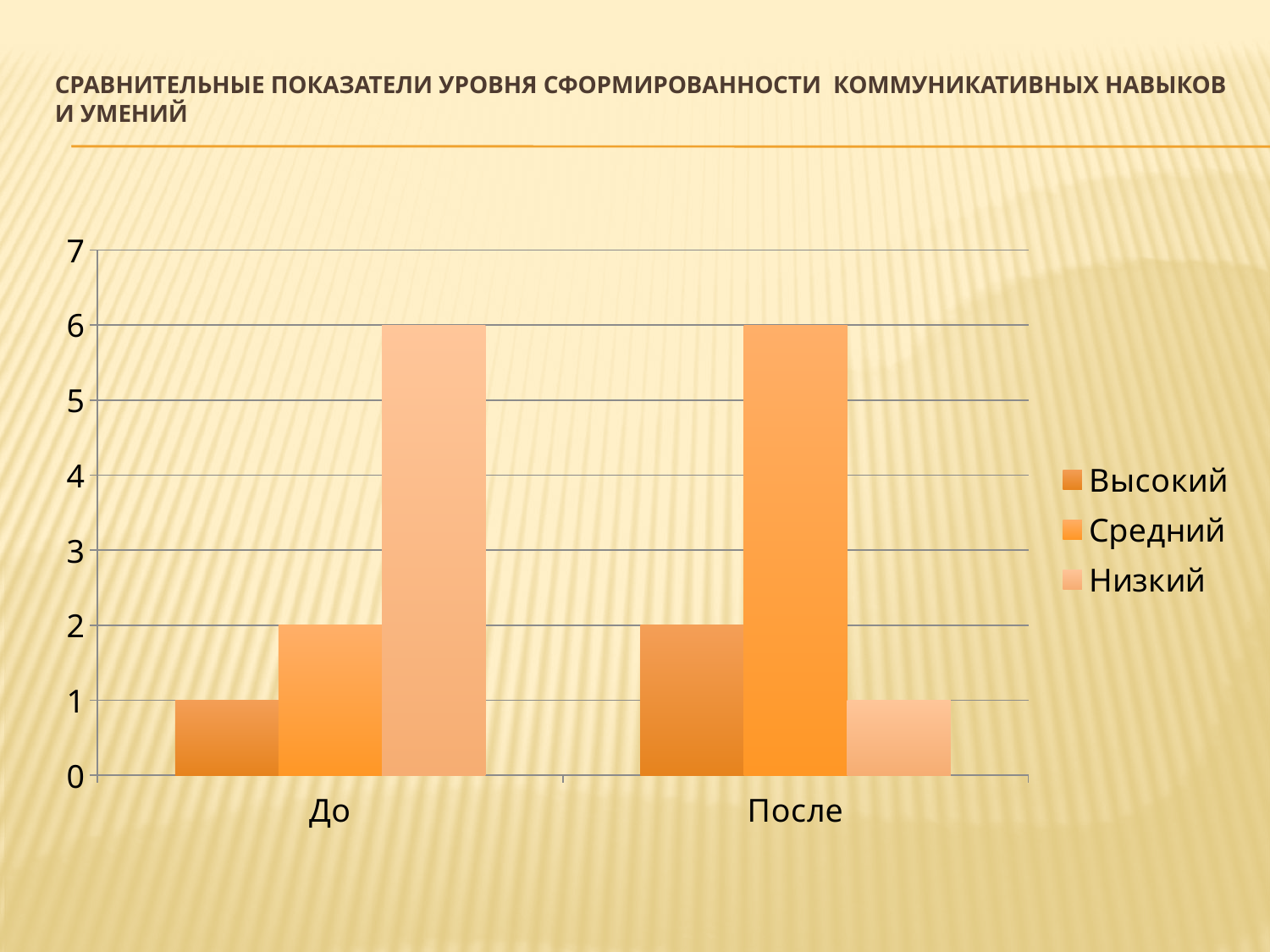
What is the value for Низкий in the После category? 1 What is the value for Низкий in the До category? 6 Which series has the lowest value in the После category? Низкий What is the difference between the Средний values for После and До? 4 What is the value for Средний in the После category? 6 How many series does the legend list? 3 What is the value for Высокий in the До category? 1 Which series has the highest value in the До category? Низкий Which is larger: the Высокий value for До or the Высокий value for После? После How many categories are shown on the x axis? 2 What kind of chart is shown on the slide? Bar chart Does the value for Низкий rise or fall from До to После? Fall